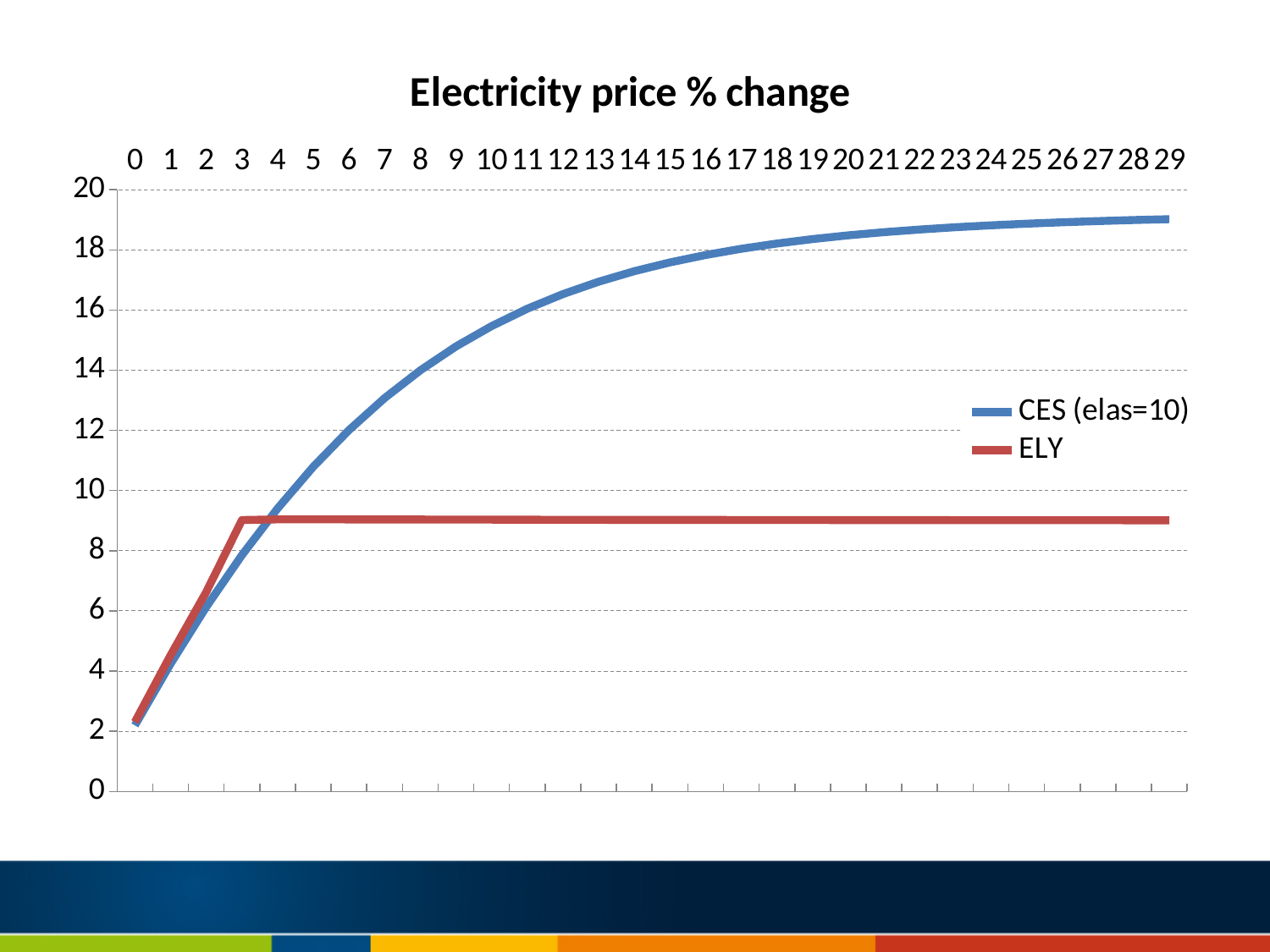
Is the value for CES (elas=10) at x = 0 greater or less than 4? less At x = 29, which series has the larger value, CES (elas=10) or ELY? CES (elas=10) Is the value for ELY at x = 20 greater or less than 10? less How many points are on the x axis (from 0 to 29)? 30 At x = 3, which series has the larger value, CES (elas=10) or ELY? ELY What kind of chart is shown on the slide? line chart Is the value for CES (elas=10) at x = 10 greater or less than 14? greater What is the title of the chart? Electricity price % change Which series is drawn in red? ELY How many series does the legend list? 2